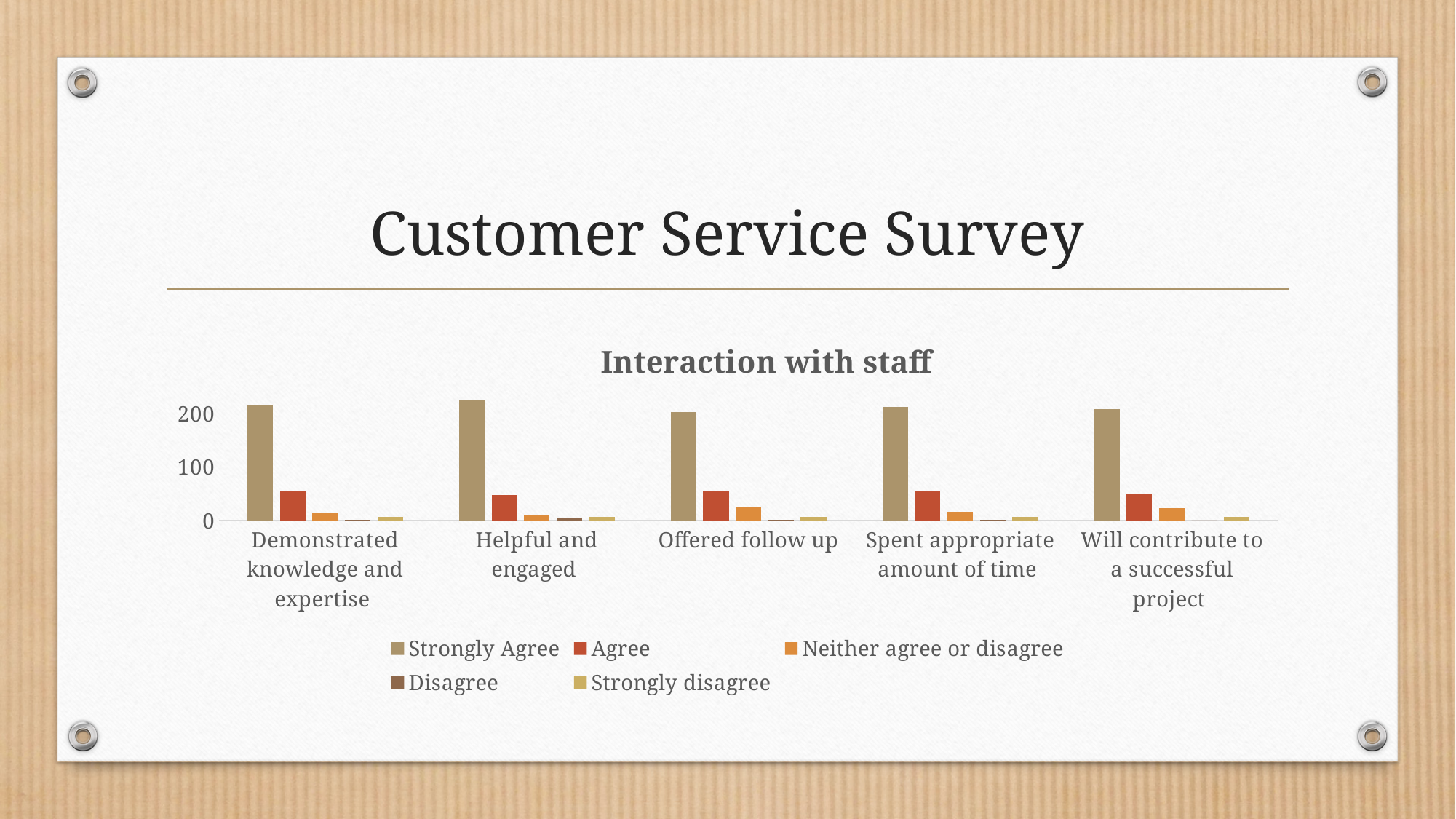
How many series does the chart's legend list? 5 Which category has the highest Strongly Agree value? Helpful and engaged For Offered follow up, which is larger: Strongly Agree or Agree? Strongly Agree For Will contribute to a successful project, which is larger: Agree or Neither agree or disagree? Agree Is the Agree value for Demonstrated knowledge and expertise greater or less than 100? less Which series has the lowest values across all categories? Disagree What kind of chart is shown on the slide? bar chart What is the title of the chart? Interaction with staff Is the Strongly Agree value for Spent appropriate amount of time greater or less than 100? greater Which series is shown in red in the chart's legend? Agree Is the Strongly Agree value for Helpful and engaged greater or less than 200? greater How many categories are shown on the x axis of the chart? 5